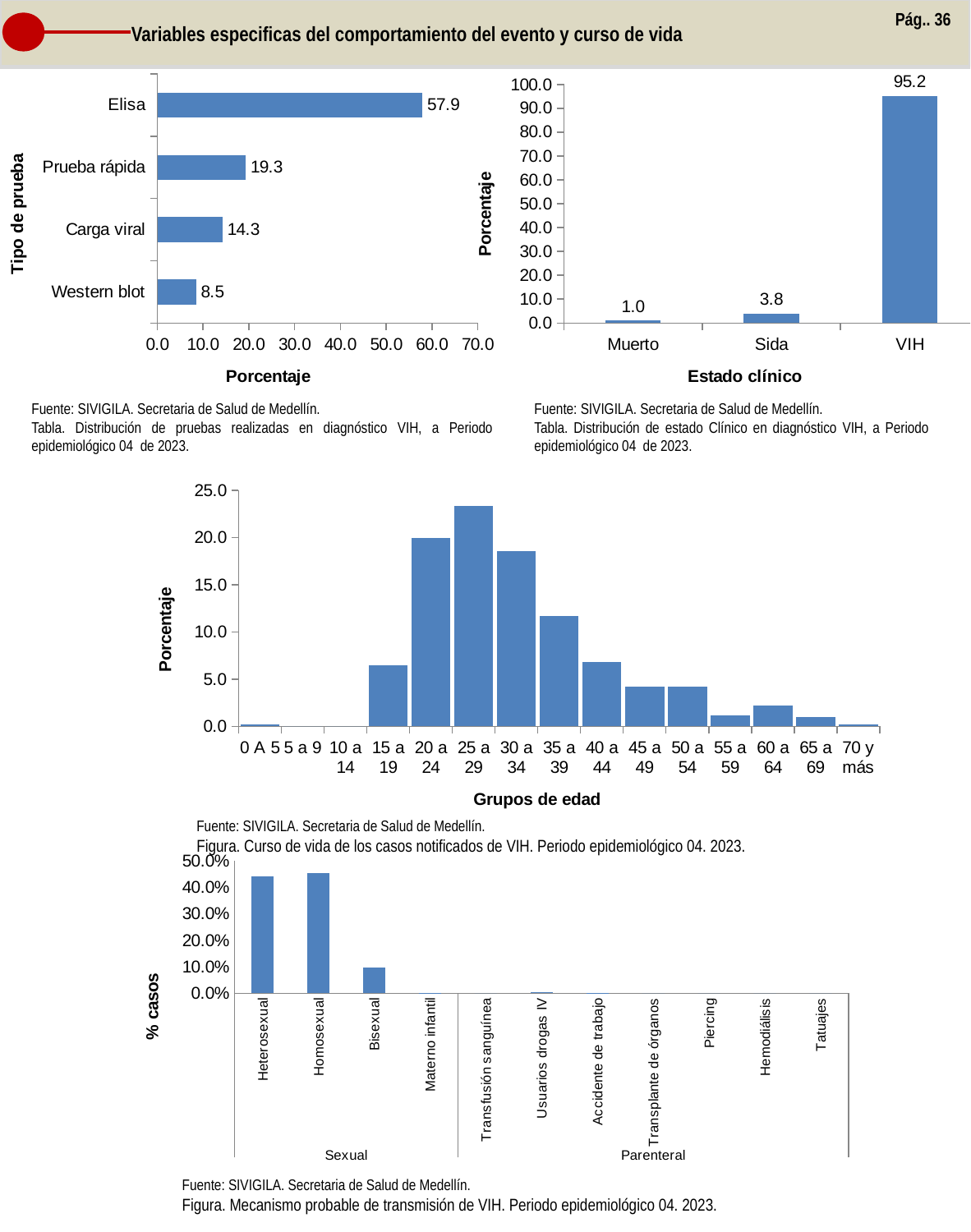
In the middle chart (Grupos de edad), is the value for 30 a 34 greater or less than 20.0? less In the top-right chart (Estado clínico), which clinical state has the highest percentage? VIH In the top-left chart (Tipo de prueba), which test type has the lowest percentage? Western blot In the middle chart (Grupos de edad), how many age groups are shown on the x axis? 15 In the top-left chart (Tipo de prueba), what is the value for Elisa? 57.9 In the top-right chart (Estado clínico), what is the difference between VIH and Muerto? 94.2 In the top-left chart (Tipo de prueba), what is the difference between Prueba rápida and Carga viral? 5.0 What kind of chart is the top-left chart (Tipo de prueba)? Bar chart In the top-right chart (Estado clínico), what is the value for Sida? 3.8 In the middle chart (Grupos de edad), which age group has the highest percentage? 25 a 29 In the top-left chart (Tipo de prueba), how many test types are shown? 4 In the bottom chart (Mecanismo probable de transmisión), is the value for Heterosexual greater or less than 40.0%? greater